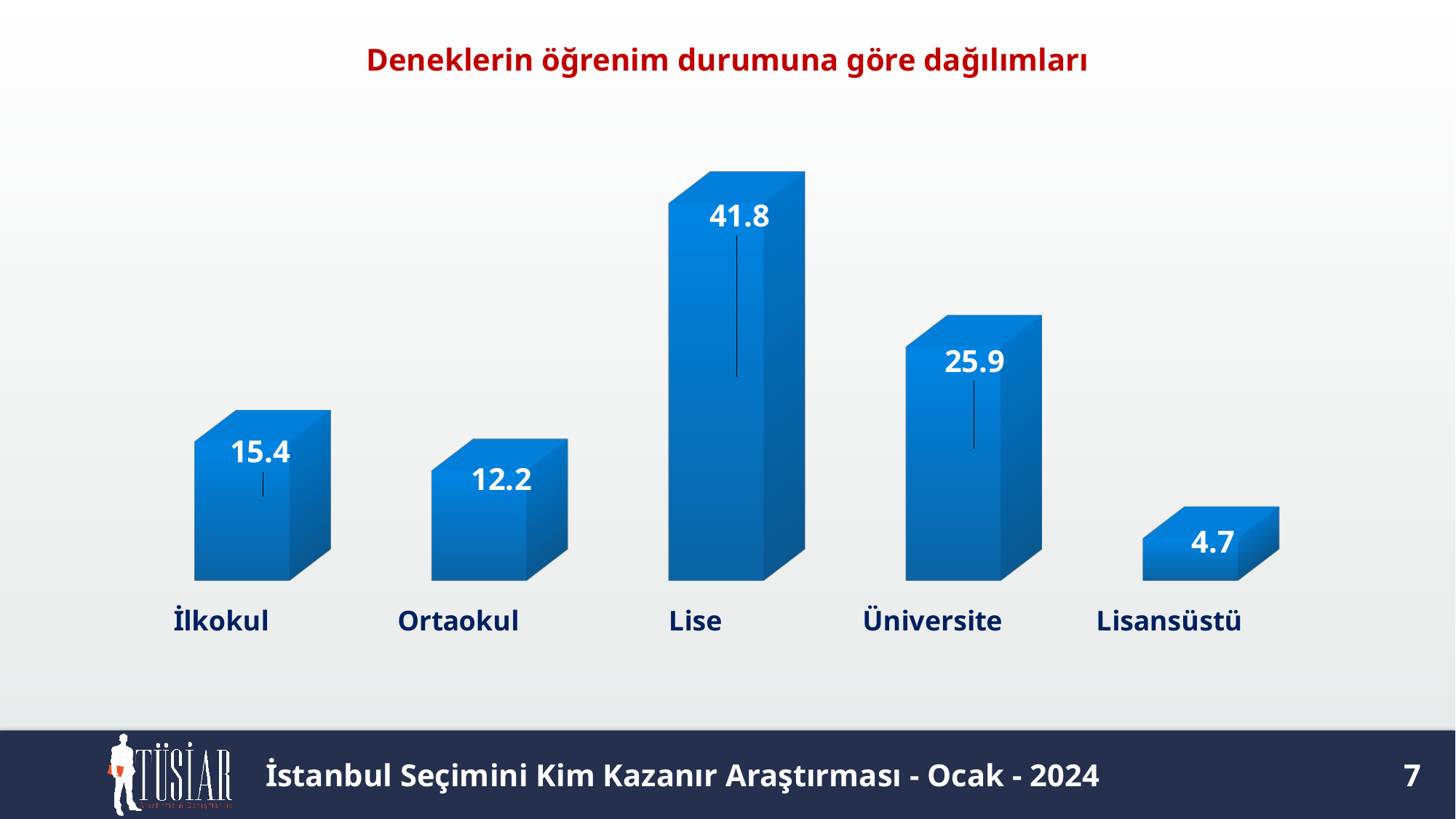
What is the value for İlkokul? 15.4 Which category has the lowest value? Lisansüstü What is the title of the chart? Deneklerin öğrenim durumuna göre dağılımları How many categories are shown in the chart? 5 What is the difference between the values for İlkokul and Ortaokul? 3.2 What is the value for Lisansüstü? 4.7 Which category has the highest value? Lise Which is larger, the value for İlkokul or the value for Ortaokul? İlkokul What is the difference between the values for Lise and Üniversite? 15.9 What kind of chart is shown on the slide? Bar chart What is the value for Üniversite? 25.9 What is the value for Lise? 41.8